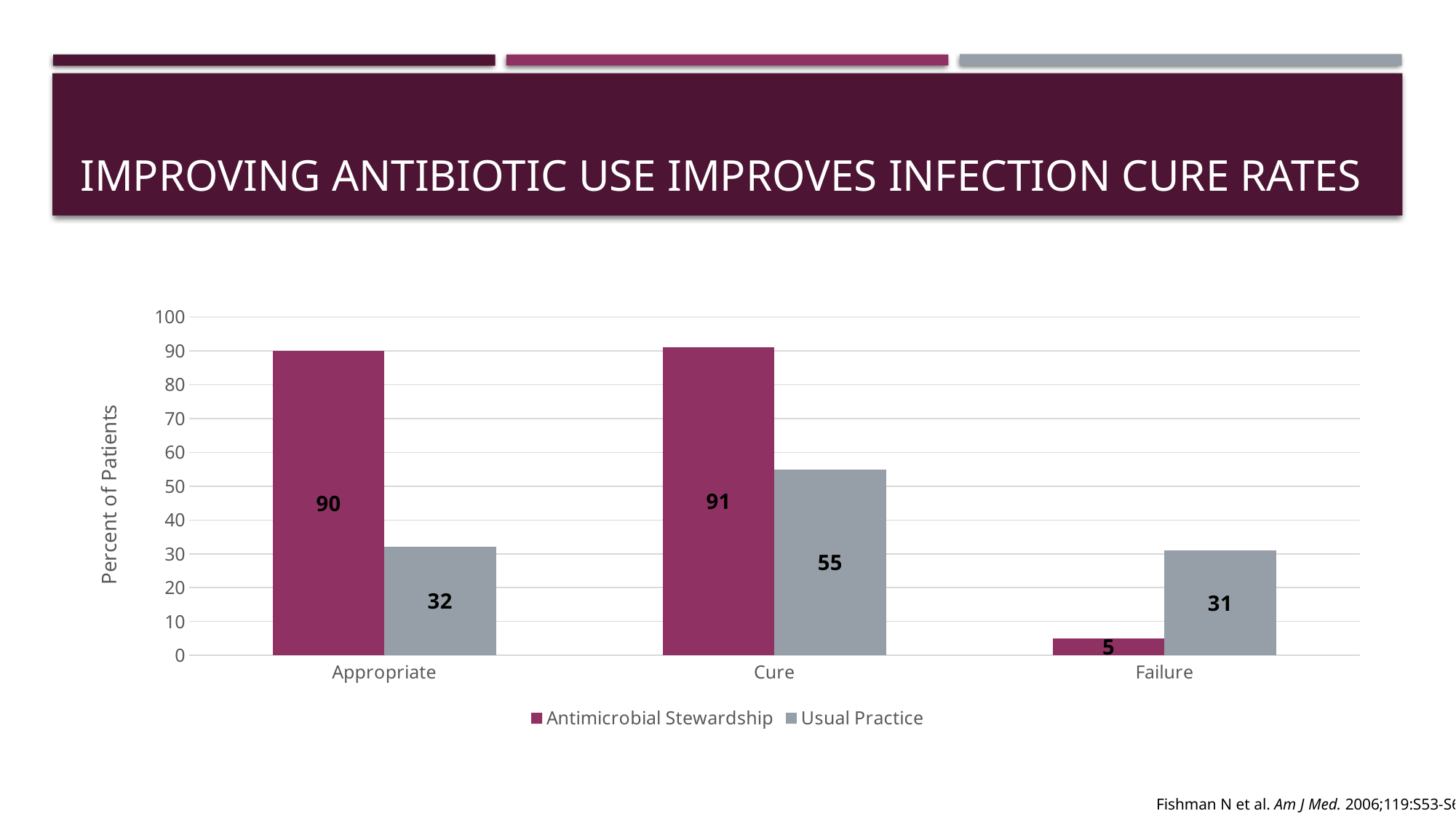
Which category has the highest value for Antimicrobial Stewardship? Cure What is the value for Usual Practice in the Cure category? 55 What is the value for Antimicrobial Stewardship in the Failure category? 5 What is the value for Antimicrobial Stewardship in the Appropriate category? 90 How many series does the legend list? 2 In the Failure category, which series has the larger value, Antimicrobial Stewardship or Usual Practice? Usual Practice What is the difference between Antimicrobial Stewardship and Usual Practice in the Appropriate category? 58 What kind of chart is shown on the slide? Bar chart How many categories are shown on the x axis? 3 What is the label of the y axis? Percent of Patients What is the value for Usual Practice in the Failure category? 31 Which category has the lowest value for Antimicrobial Stewardship? Failure